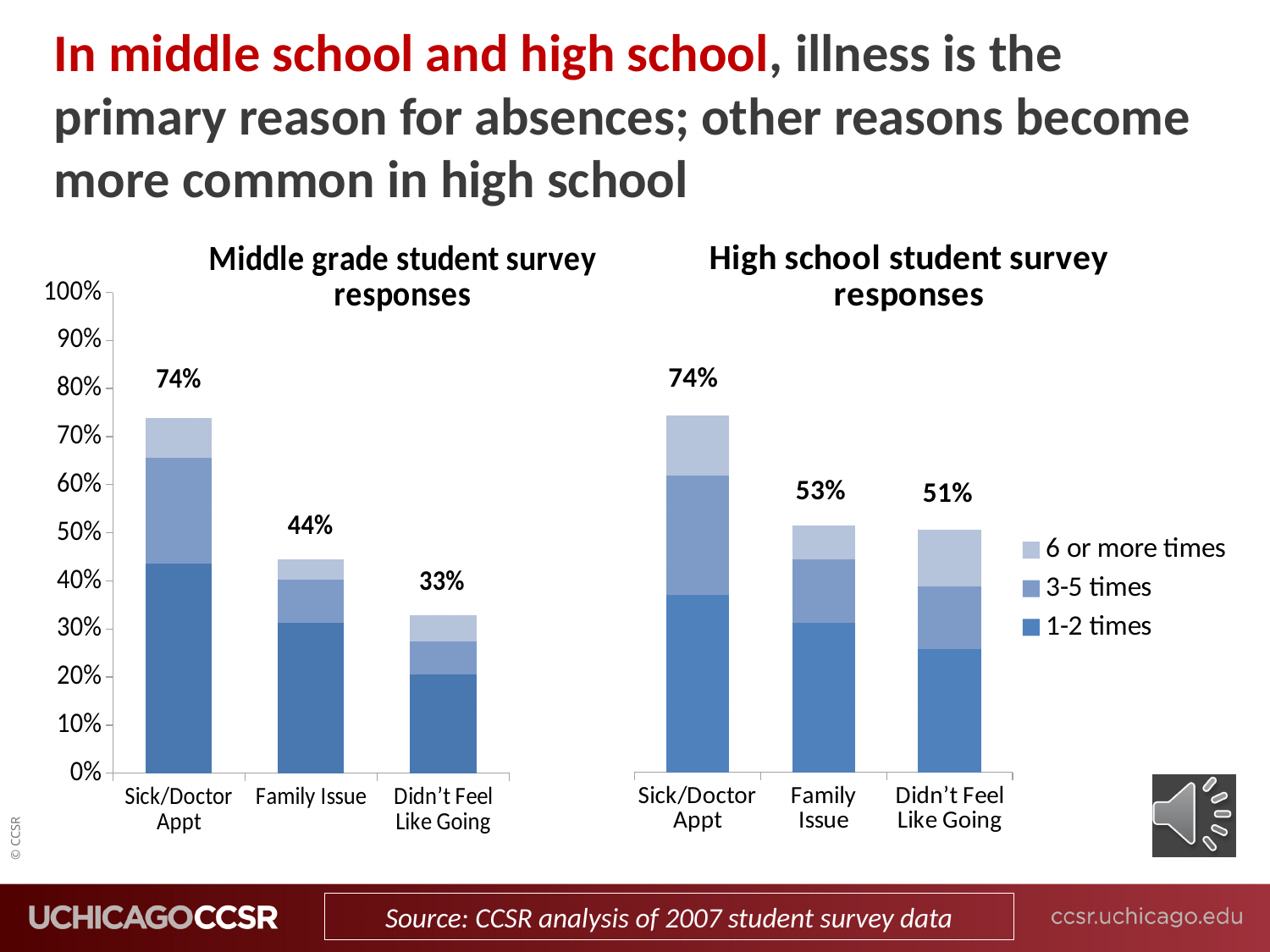
How many series does the legend list for the charts? 3 Is the Didn't Feel Like Going total larger in the Middle grade chart or the High school chart? High school chart In the High school student survey responses chart, which category has the highest total? Sick/Doctor Appt What is the difference between the Family Issue totals in the High school chart and the Middle grade chart? 9% In the High school student survey responses chart, what is the total labeled for Didn't Feel Like Going? 51% In the Middle grade student survey responses chart, which category has the lowest total? Didn't Feel Like Going In the Middle grade student survey responses chart, what is the difference between the Sick/Doctor Appt total and the Didn't Feel Like Going total? 41% In the Middle grade student survey responses chart, what is the total labeled for Sick/Doctor Appt? 74% What kind of chart is the High school student survey responses chart? Stacked bar chart In the Middle grade student survey responses chart, what is the total labeled for Family Issue? 44% In the Middle grade student survey responses chart, is the 1-2 times segment for Sick/Doctor Appt greater or less than 40%? greater In the High school student survey responses chart, what is the total labeled for Family Issue? 53%